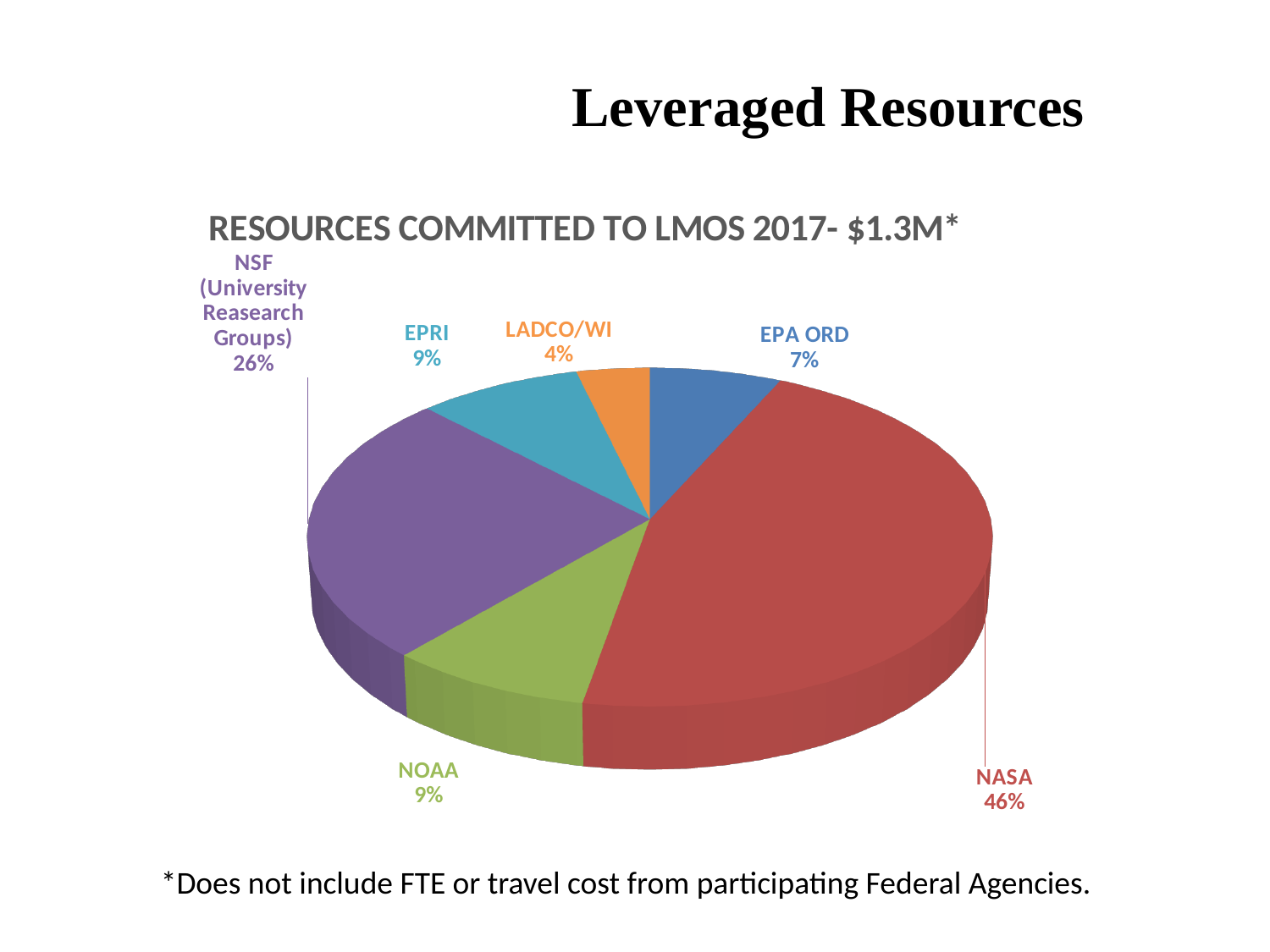
What share of the pie does NASA account for? 46% Which category has the smallest slice of the pie? LADCO/WI Which is larger, the share for EPA ORD or the share for EPRI? EPRI Which category has the largest slice of the pie? NASA What kind of chart is shown on the slide? Pie chart What is the title of the chart? RESOURCES COMMITTED TO LMOS 2017- $1.3M* What percentage is shown for EPA ORD? 7% What colour is the NOAA slice? Green How many categories are shown in the pie chart? 6 What percentage is shown for LADCO/WI? 4% What is the difference in percentage points between NASA and NSF (University Reasearch Groups)? 20 What percentage is shown for NSF (University Reasearch Groups)? 26%